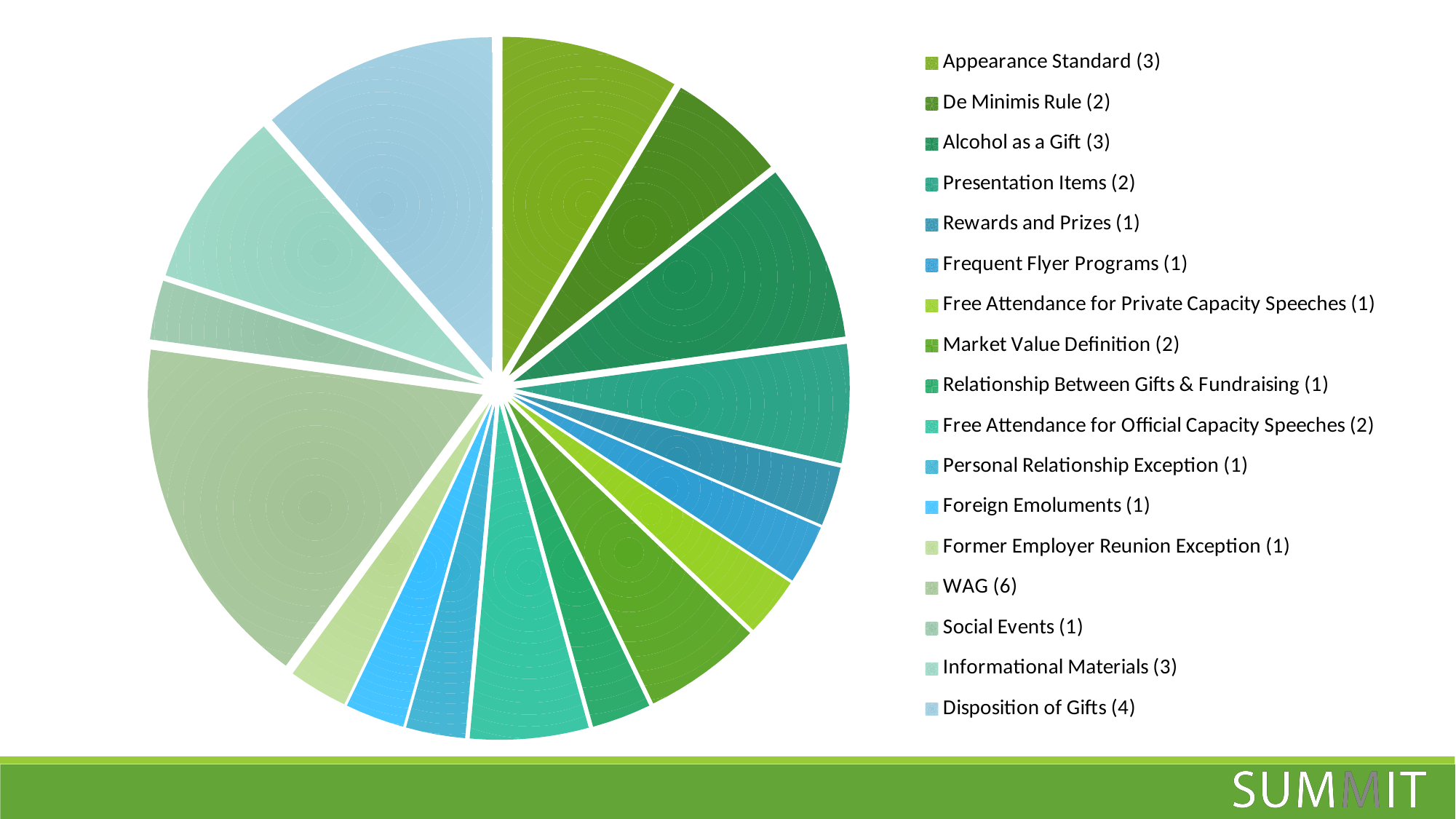
What is the value for Appearance Standard? 3 How many categories does the pie chart have? 17 What is the value for WAG? 6 What kind of chart is shown on the slide? pie chart What is the difference between the values for Alcohol as a Gift and Rewards and Prizes? 2 Which is larger, the value for Informational Materials or the value for De Minimis Rule? Informational Materials Which is larger, the value for Disposition of Gifts or the value for Presentation Items? Disposition of Gifts What is the difference between the values for WAG and Disposition of Gifts? 2 Which category has the largest value in the pie chart? WAG What is the value for Disposition of Gifts? 4 What is the value for Free Attendance for Official Capacity Speeches? 2 What is the value for Foreign Emoluments? 1